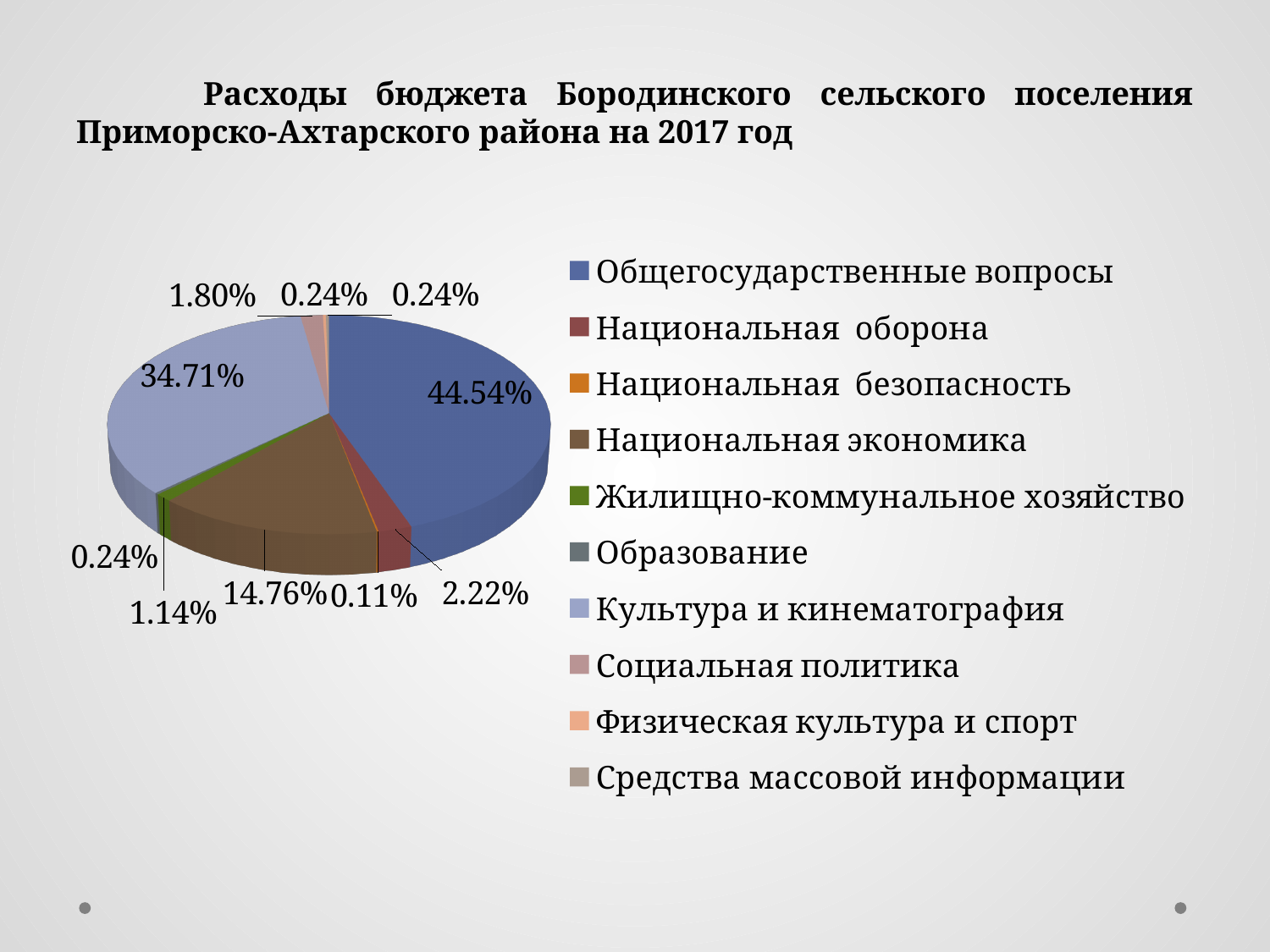
What share of the budget expenses goes to Общегосударственные вопросы? 44.54% Which category has the smallest share of the budget expenses? Национальная безопасность What share of the budget expenses goes to Культура и кинематография? 34.71% How many categories does the legend list? 10 Which is larger: the share for Национальная экономика or the share for Национальная оборона? Национальная экономика What share of the budget expenses goes to Национальная экономика? 14.76% What is the difference in percentage points between Общегосударственные вопросы and Культура и кинематография? 9.83 What kind of chart is shown on the slide? Pie chart Which category has the largest share of the budget expenses? Общегосударственные вопросы What share of the budget expenses goes to Жилищно-коммунальное хозяйство? 1.14% What share of the budget expenses goes to Социальная политика? 1.80% What share of the budget expenses goes to Национальная оборона? 2.22%